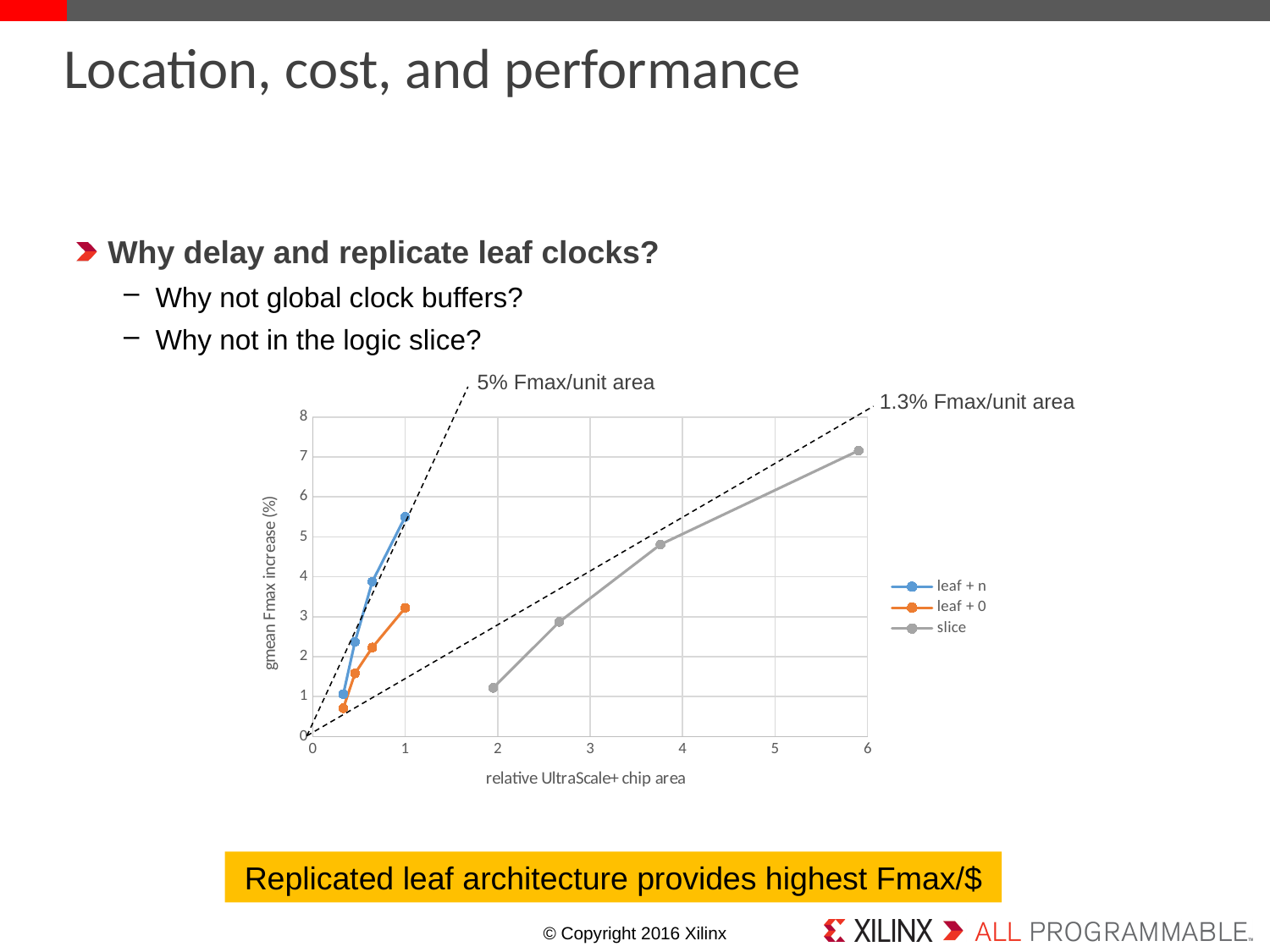
How many data points are plotted for the leaf + n series? 4 Which series extends to the largest relative UltraScale+ chip area? slice What kind of chart is shown on the slide? line chart Is the highest gmean Fmax increase for the leaf + n series greater or less than 5? greater What is the label of the chart's vertical axis? gmean Fmax increase (%) At a relative chip area of 1, which series has the larger gmean Fmax increase, leaf + n or leaf + 0? leaf + n How many series does the chart legend list? 3 Is the highest gmean Fmax increase for the leaf + 0 series greater or less than 4? less What are the three series named in the chart legend? leaf + n, leaf + 0, slice Does the gmean Fmax increase for the slice series rise or fall as relative chip area increases? rise Which series reaches the highest gmean Fmax increase on the chart? slice How many data points are plotted for the slice series? 4